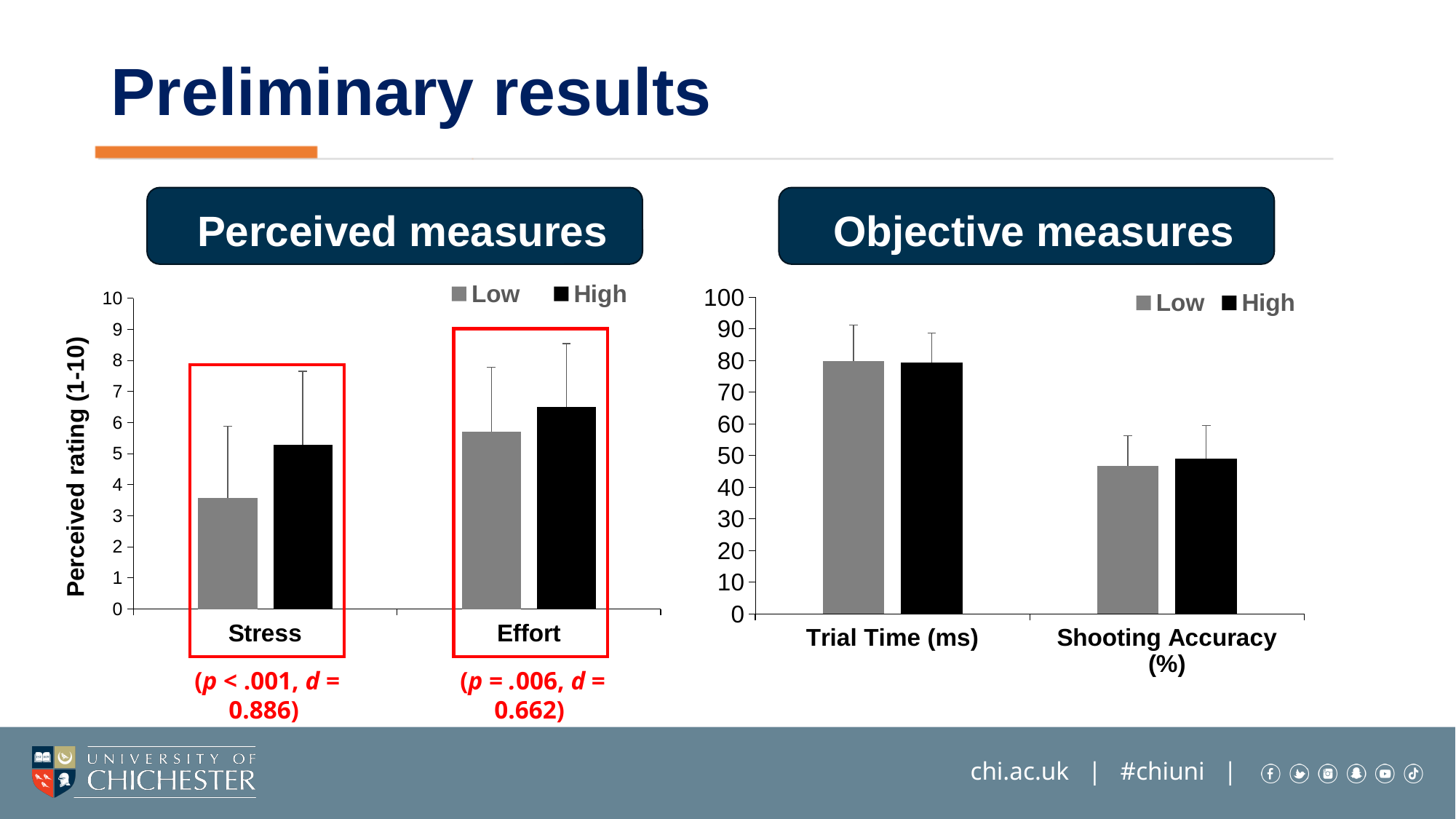
How many categories are shown on the x axis of the Perceived measures chart? 2 What is the y-axis title of the Perceived measures chart? Perceived rating (1-10) In the Perceived measures chart, which is larger for Stress, Low or High? High In the Objective measures chart, is the Low value for Trial Time (ms) greater or less than 70? greater In the Perceived measures chart, is the High value for Stress greater or less than 5? greater What kind of chart is the Perceived measures chart? bar chart In the Perceived measures chart, is the Low value for Stress greater or less than 4? less In the Perceived measures chart, which bar is the highest? Effort, High In the Perceived measures chart, which bar is the lowest? Stress, Low How many series does the legend of the Objective measures chart list? 2 What are the two categories on the x axis of the Objective measures chart? Trial Time (ms) and Shooting Accuracy (%)